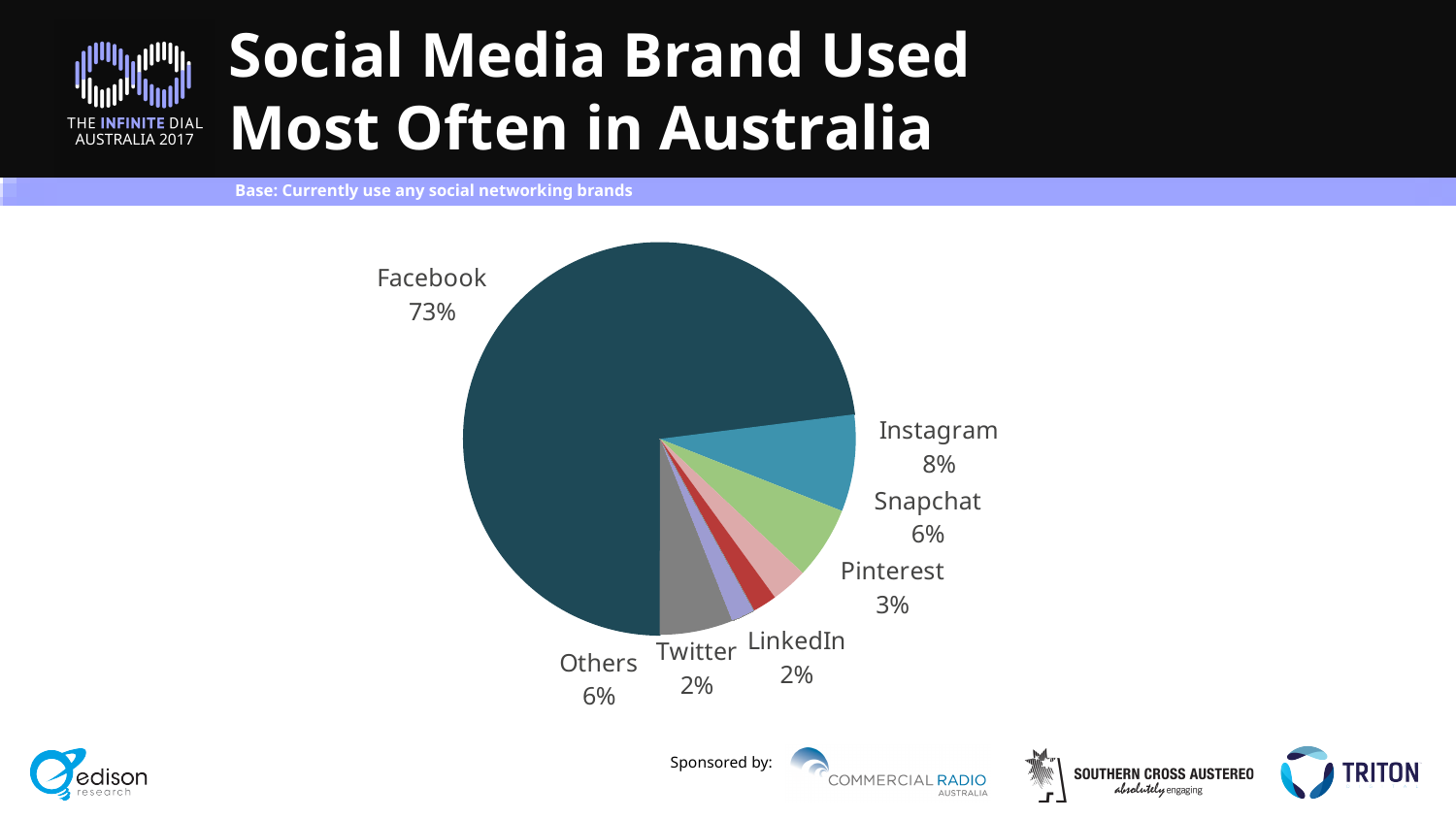
How many slices does the pie chart have? 7 What is the difference between the Facebook and Instagram values? 65% What is the value for Snapchat? 6% Which is larger, the value for Instagram or the value for Pinterest? Instagram Which social media brand has the largest slice of the pie? Facebook What kind of chart is shown on the slide? Pie chart What is the value for Instagram? 8% What share of the pie does Facebook have? 73% What is the value for LinkedIn? 2% What is the title of the chart on the slide? Social Media Brand Used Most Often in Australia What is the difference between the Snapchat and LinkedIn values? 4% What is the value for Pinterest? 3%